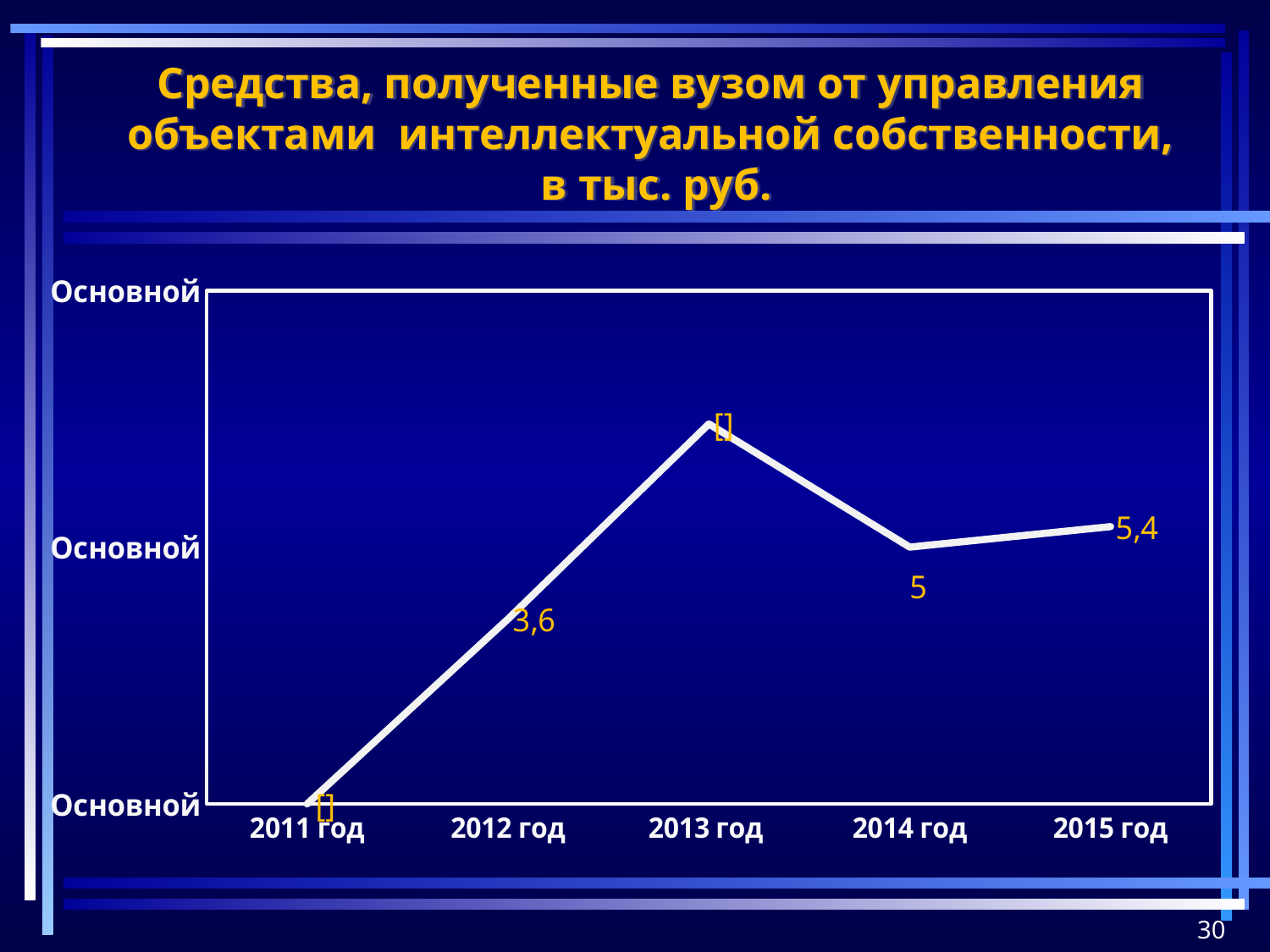
What is the difference between the values for 2015 год and 2014 год? 0,4 How many years are shown on the x axis? 5 What is the difference between the values for 2014 год and 2012 год? 1,4 What is the value for 2014 год? 5 Which year has the lowest value on the chart? 2011 год What kind of chart is shown on the slide? line chart Which is larger, the value for 2012 год or the value for 2014 год? 2014 год What is the value for 2012 год? 3,6 Does the value rise or fall from 2013 год to 2014 год? fall Which year has the highest value on the chart? 2013 год Which is larger, the value for 2014 год or the value for 2015 год? 2015 год What is the value for 2015 год? 5,4